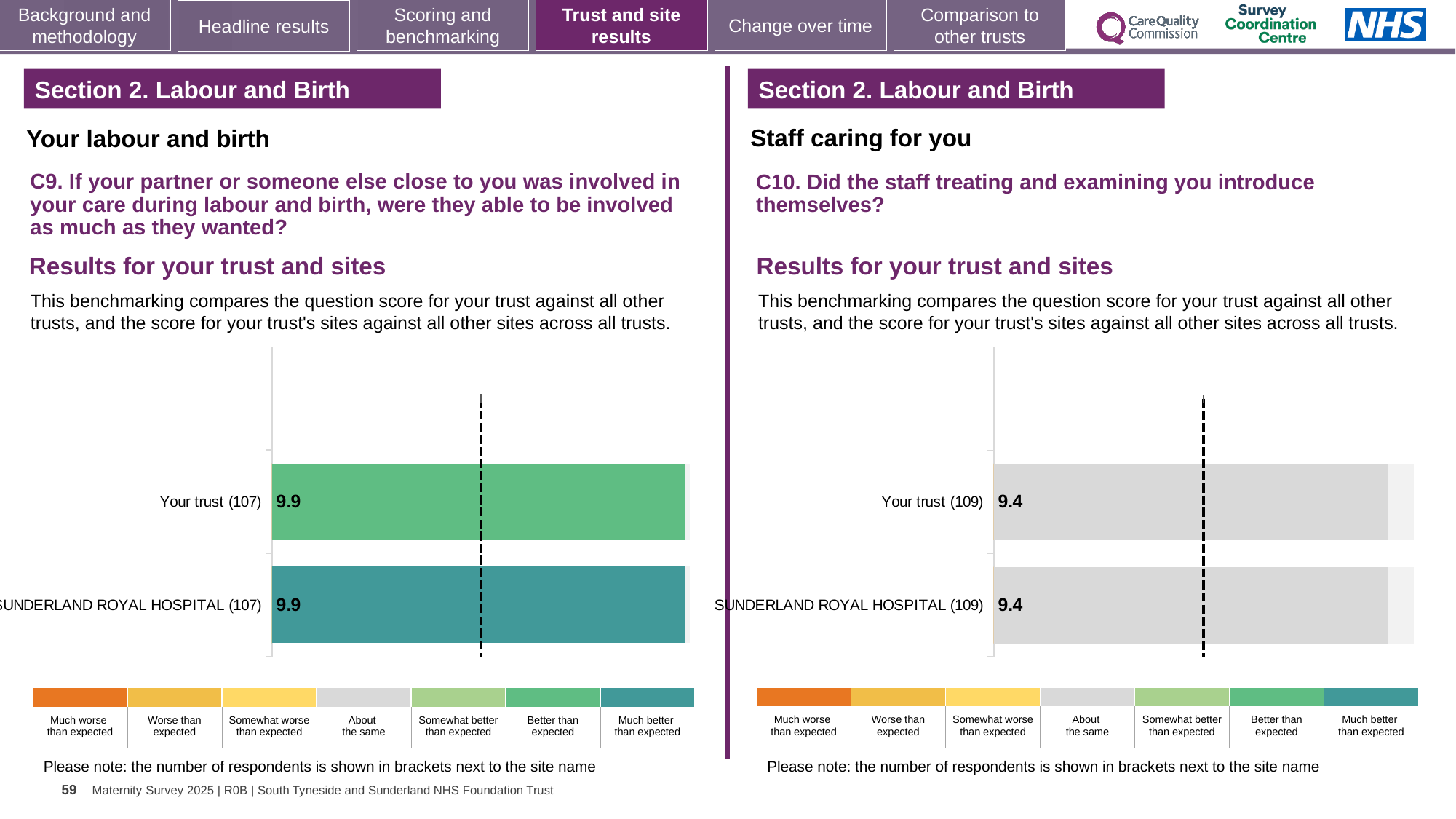
On the right chart (C10), what is the score for Your trust (109)? 9.4 On the right chart (C10), what is the difference between the score for Your trust and the score for SUNDERLAND ROYAL HOSPITAL? 0 On the right chart (C10), what is the score for SUNDERLAND ROYAL HOSPITAL (109)? 9.4 On the left chart (C9), what is the difference between the score for Your trust and the score for SUNDERLAND ROYAL HOSPITAL? 0 Which is larger: the Your trust score on the left chart (C9) or the Your trust score on the right chart (C10)? Left chart (C9), 9.9 What kind of chart is used on the left (C9)? Bar chart How many bars are plotted on the left chart (C9)? 2 On the left chart (C9), what is the score for SUNDERLAND ROYAL HOSPITAL (107)? 9.9 How many bars are plotted on the right chart (C10)? 2 On the left chart (C9), what is the score for Your trust (107)? 9.9 On the right chart (C10), which benchmark category does the grey colour of the bars correspond to in the legend? About the same On the left chart (C9), which benchmark category does the colour of the SUNDERLAND ROYAL HOSPITAL bar correspond to in the legend? Much better than expected